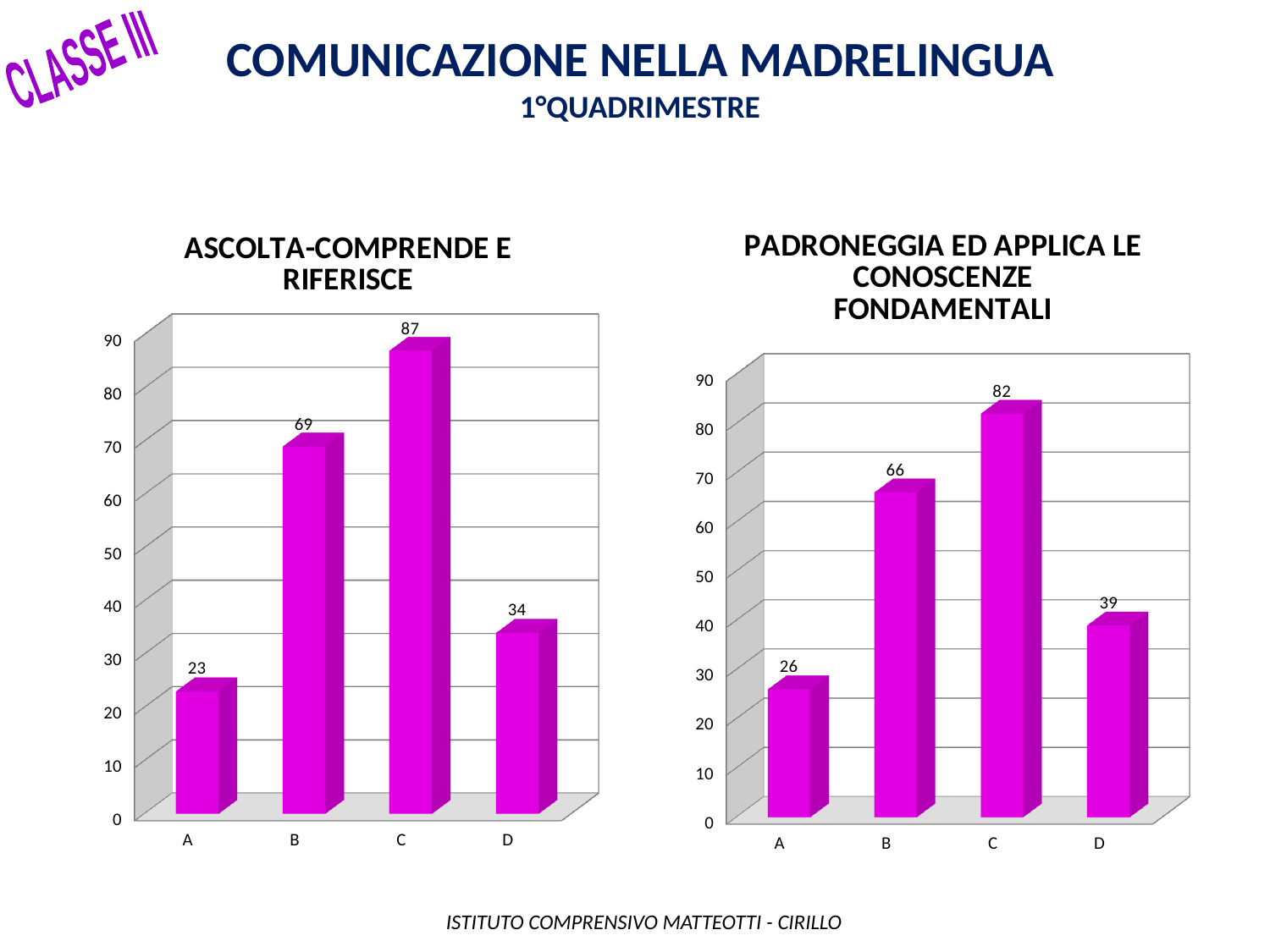
In the 'ASCOLTA-COMPRENDE E RIFERISCE' chart, what is the value for category C? 87 In the 'ASCOLTA-COMPRENDE E RIFERISCE' chart, what is the difference between the values for C and B? 18 In the 'PADRONEGGIA ED APPLICA LE CONOSCENZE FONDAMENTALI' chart, what is the value for category B? 66 In the 'ASCOLTA-COMPRENDE E RIFERISCE' chart, what is the value for category A? 23 In the 'PADRONEGGIA ED APPLICA LE CONOSCENZE FONDAMENTALI' chart, which category has the lowest value? A In the 'PADRONEGGIA ED APPLICA LE CONOSCENZE FONDAMENTALI' chart, what is the difference between the values for D and A? 13 In the 'PADRONEGGIA ED APPLICA LE CONOSCENZE FONDAMENTALI' chart, is the value for C greater or less than 80? greater In the 'ASCOLTA-COMPRENDE E RIFERISCE' chart, which category has the highest value? C What kind of chart is the 'PADRONEGGIA ED APPLICA LE CONOSCENZE FONDAMENTALI' chart? bar chart In the 'ASCOLTA-COMPRENDE E RIFERISCE' chart, which is larger, the value for B or the value for D? B How many categories are shown in the 'ASCOLTA-COMPRENDE E RIFERISCE' chart? 4 In the 'PADRONEGGIA ED APPLICA LE CONOSCENZE FONDAMENTALI' chart, what is the value for category D? 39